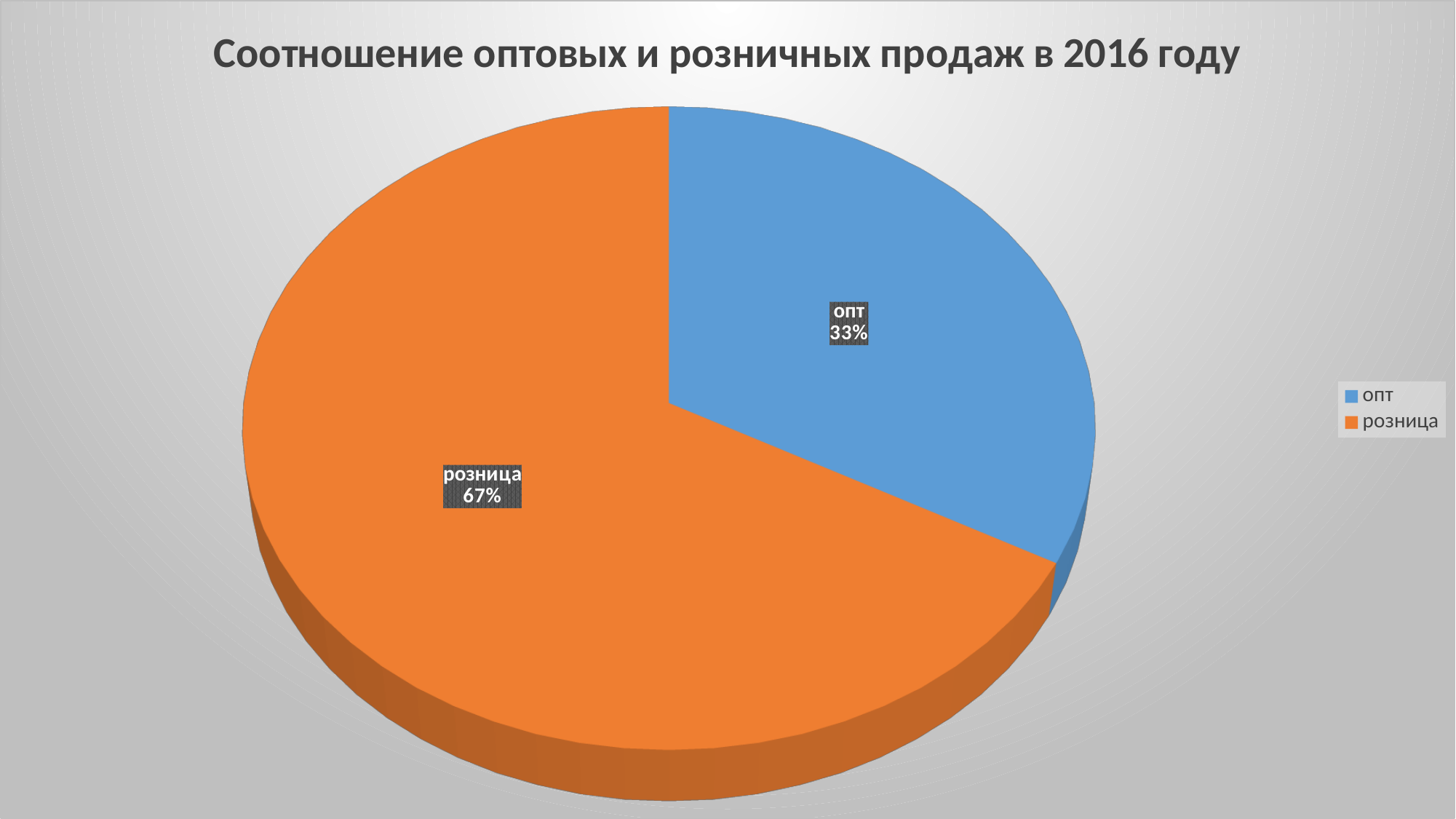
How many entries does the legend list? 2 What is the difference in percentage points between the "розница" and "опт" slices? 34 How many slices does the pie chart have? 2 What share of the pie does the "розница" slice represent? 67% What colour is the "опт" slice? blue What share of the pie does the "опт" slice represent? 33% What is the title of the chart? Соотношение оптовых и розничных продаж в 2016 году Which category has the largest slice of the pie? розница Which category has the smallest slice of the pie? опт Which slice is larger, "опт" or "розница"? розница What kind of chart is shown on the slide? pie chart